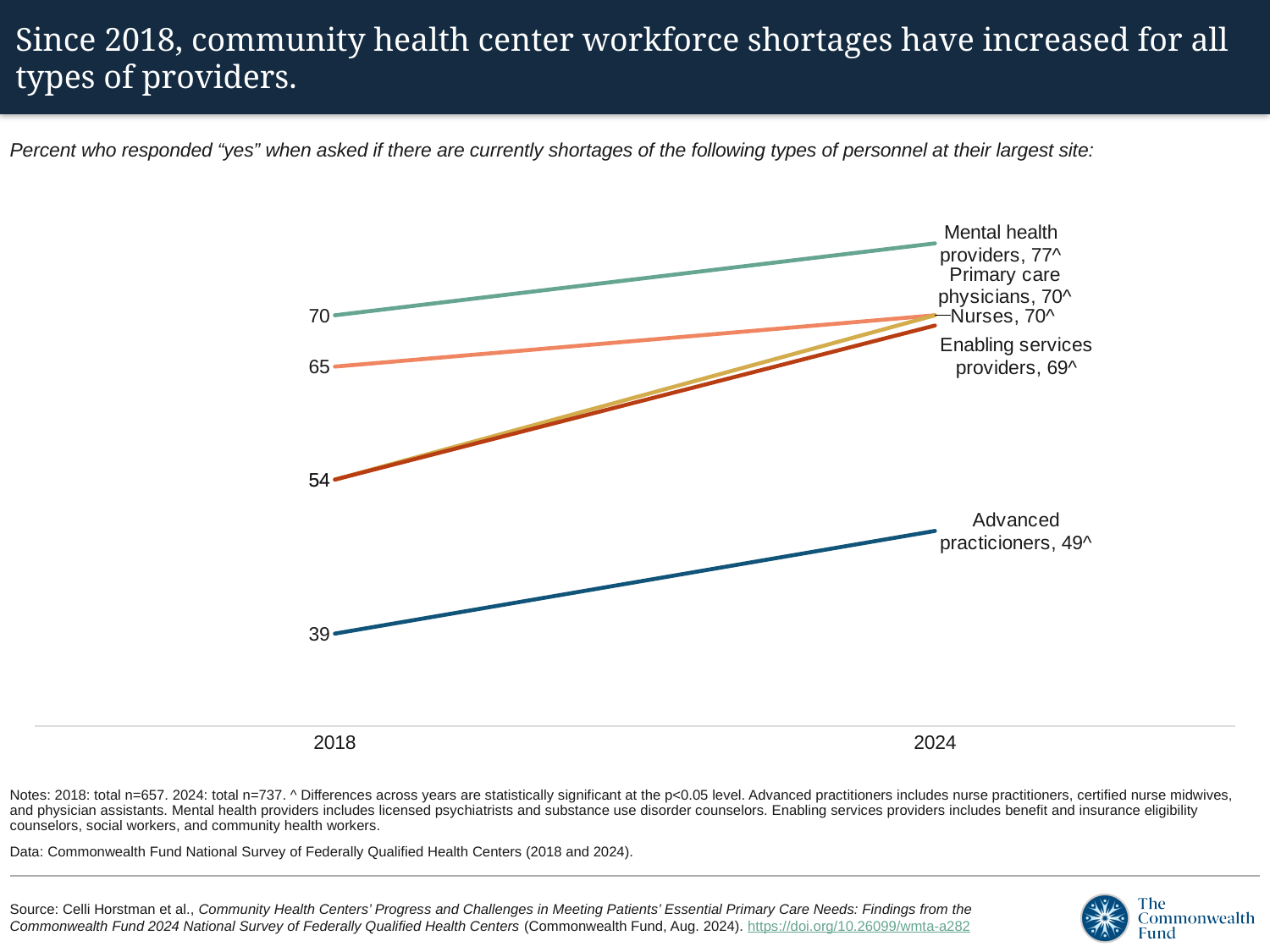
In 2024, which is larger: the value for mental health providers or the value for advanced practitioners? Mental health providers What is the 2024 value for enabling services providers? 69 By how many points did the value for mental health providers increase from 2018 to 2024? 7 Which type of provider had the highest reported shortage in 2024? Mental health providers Do the values for all provider types rise or fall from 2018 to 2024? Rise How many types of providers are plotted on the chart? 5 What percentage of community health centers reported shortages of mental health providers in 2024? 77 What was the value for advanced practitioners in 2018? 39 By how many points did the value for advanced practitioners increase from 2018 to 2024? 10 What is the 2024 value for advanced practitioners? 49 Which type of provider had the lowest reported shortage in 2024? Advanced practicioners